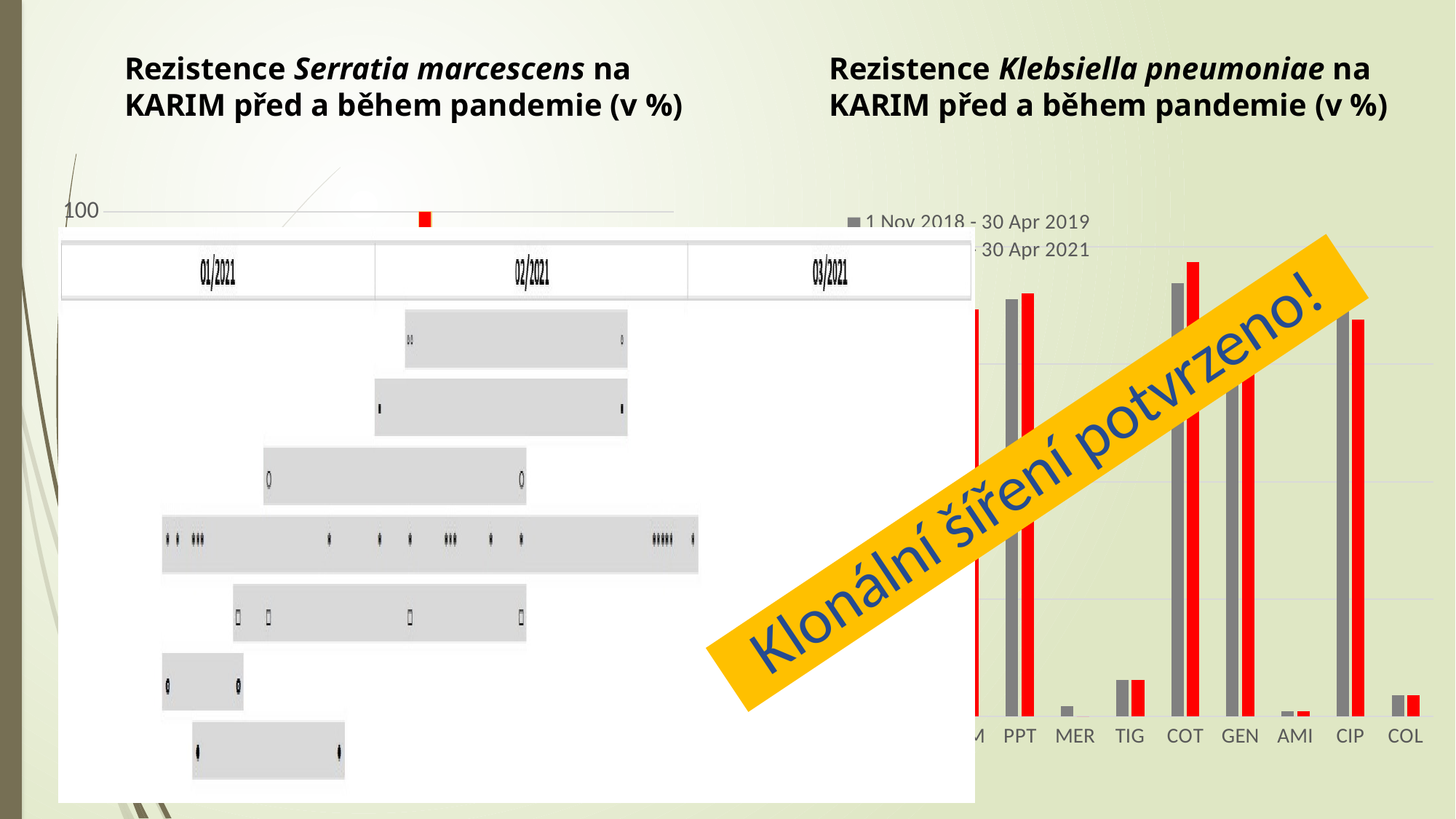
In the Klebsiella pneumoniae chart on the right, which category has higher bars, AMI or PPT? PPT In the Klebsiella pneumoniae chart on the right, what is the first legend entry? 1 Nov 2018 - 30 Apr 2019 In the Klebsiella pneumoniae chart on the right, for GEN, which bar is taller, the grey one or the red one? grey In the Klebsiella pneumoniae chart on the right, which category has higher bars, CIP or MER? CIP In the Klebsiella pneumoniae chart on the right, which readable category has the tallest bar? COT What is the title of the chart on the left side of the slide? Rezistence Serratia marcescens na KARIM před a během pandemie (v %) What kind of chart is the 'Rezistence Klebsiella pneumoniae na KARIM před a během pandemie (v %)' chart on the right? bar chart